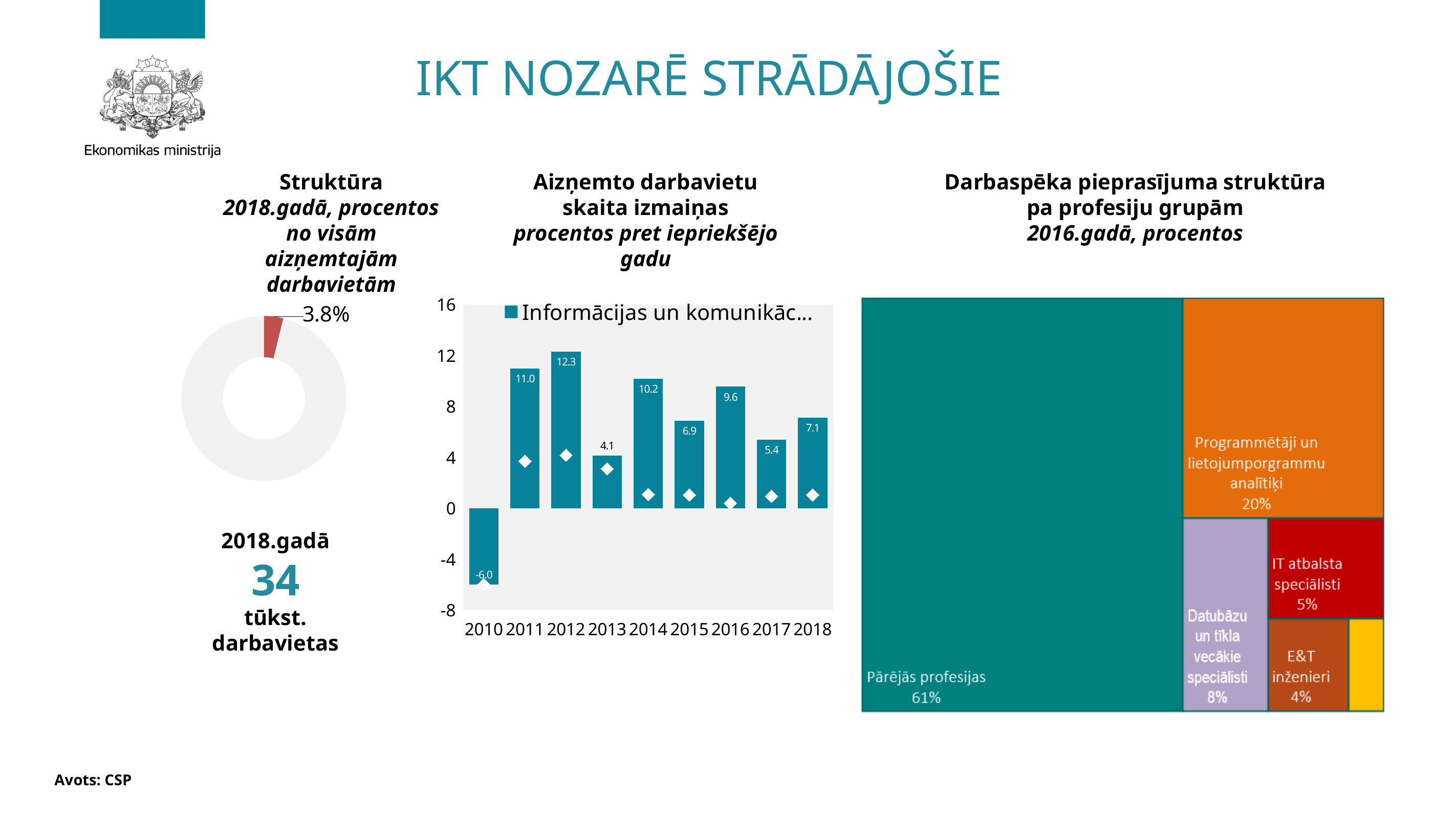
In the middle chart (Aizņemto darbavietu skaita izmaiņas), which year has the highest bar? 2012 In the right chart (Darbaspēka pieprasījuma struktūra pa profesiju grupām), what share is shown for Programmētāji un lietojumprogrammu analītiķi? 20% In the middle chart (Aizņemto darbavietu skaita izmaiņas), what is the value for 2010? -6.0 What kind of chart is the middle chart (Aizņemto darbavietu skaita izmaiņas)? combination bar and line chart (bars with diamond markers) In the middle chart (Aizņemto darbavietu skaita izmaiņas), what is the value for 2012? 12.3 In the middle chart (Aizņemto darbavietu skaita izmaiņas), how many years are shown on the x axis? 9 In the right chart (Darbaspēka pieprasījuma struktūra pa profesiju grupām), what is the difference between the shares of Datubāzu un tīkla vecākie speciālisti and E&T inženieri? 4% In the middle chart (Aizņemto darbavietu skaita izmaiņas), what is the difference between the 2014 and 2013 bar values? 6.1 In the right chart (Darbaspēka pieprasījuma struktūra pa profesiju grupām), which labelled group has the largest share? Pārējās profesijas In the left donut chart (Struktūra 2018.gadā), what percentage is shown for the highlighted slice? 3.8% In the middle chart (Aizņemto darbavietu skaita izmaiņas), which bar is larger, 2016 or 2017? 2016 In the middle chart (Aizņemto darbavietu skaita izmaiņas), which year has the lowest bar? 2010